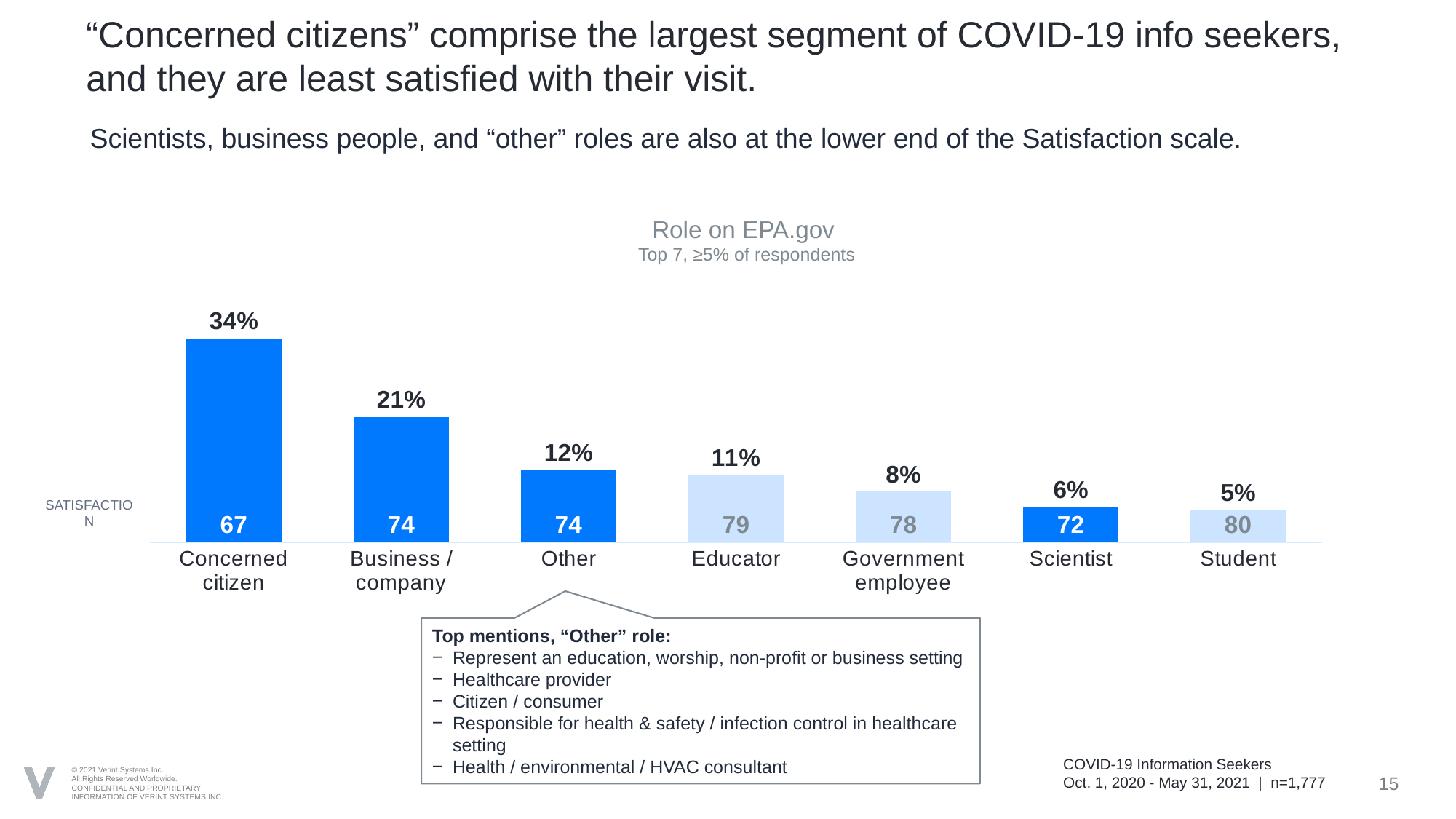
What is the satisfaction score shown for the Educator role? 79 How many roles are shown in the chart? 7 What percentage of respondents selected "Government employee" as their role? 8% What is the title of the chart? Role on EPA.gov Which role has the highest satisfaction score? Student What is the difference in percentage points between the Concerned citizen and Business / company shares of respondents? 13 Which role has the lowest satisfaction score? Concerned citizen What type of chart is used to show the roles on EPA.gov? Bar chart What percentage of respondents selected "Concerned citizen" as their role on EPA.gov? 34% Which role has the highest percentage of respondents? Concerned citizen Which role has the lowest percentage of respondents? Student Which role has a larger share of respondents, Educator or Scientist? Educator